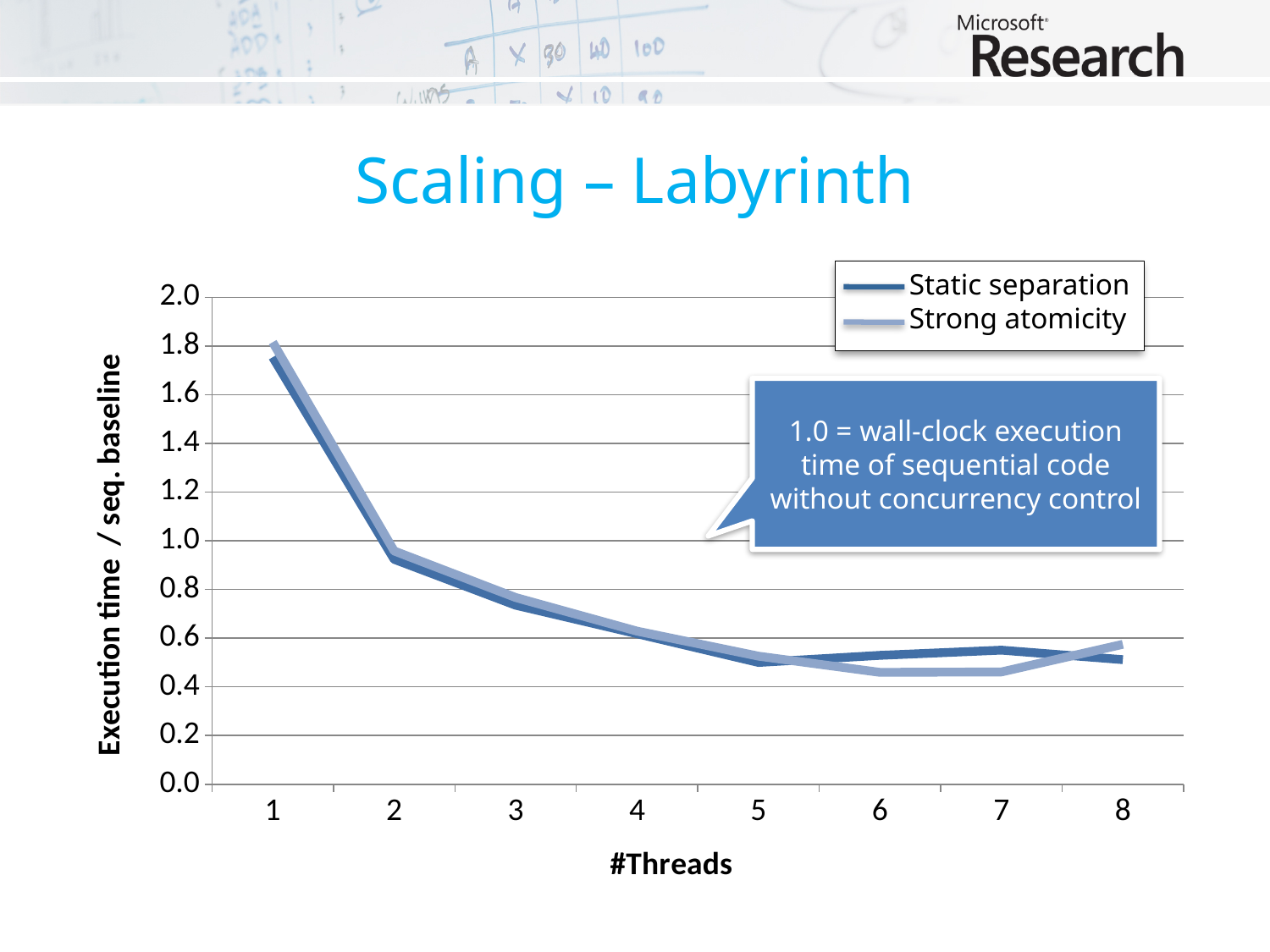
Is the value for Static separation at 3 threads greater or less than 0.8? less What kind of chart is shown on the slide? Line chart Is the value for Static separation at 1 thread greater or less than 1.6? greater Do the execution time values rise or fall as the number of threads increases from 1 to 5? Fall How many series does the legend list? 2 How many thread counts are plotted along the x axis? 8 At 6 threads, which series has the higher execution time, Static separation or Strong atomicity? Static separation Is the value for Static separation at 8 threads greater or less than 0.4? greater What is the label of the x axis? #Threads What is the title of the chart? Scaling – Labyrinth